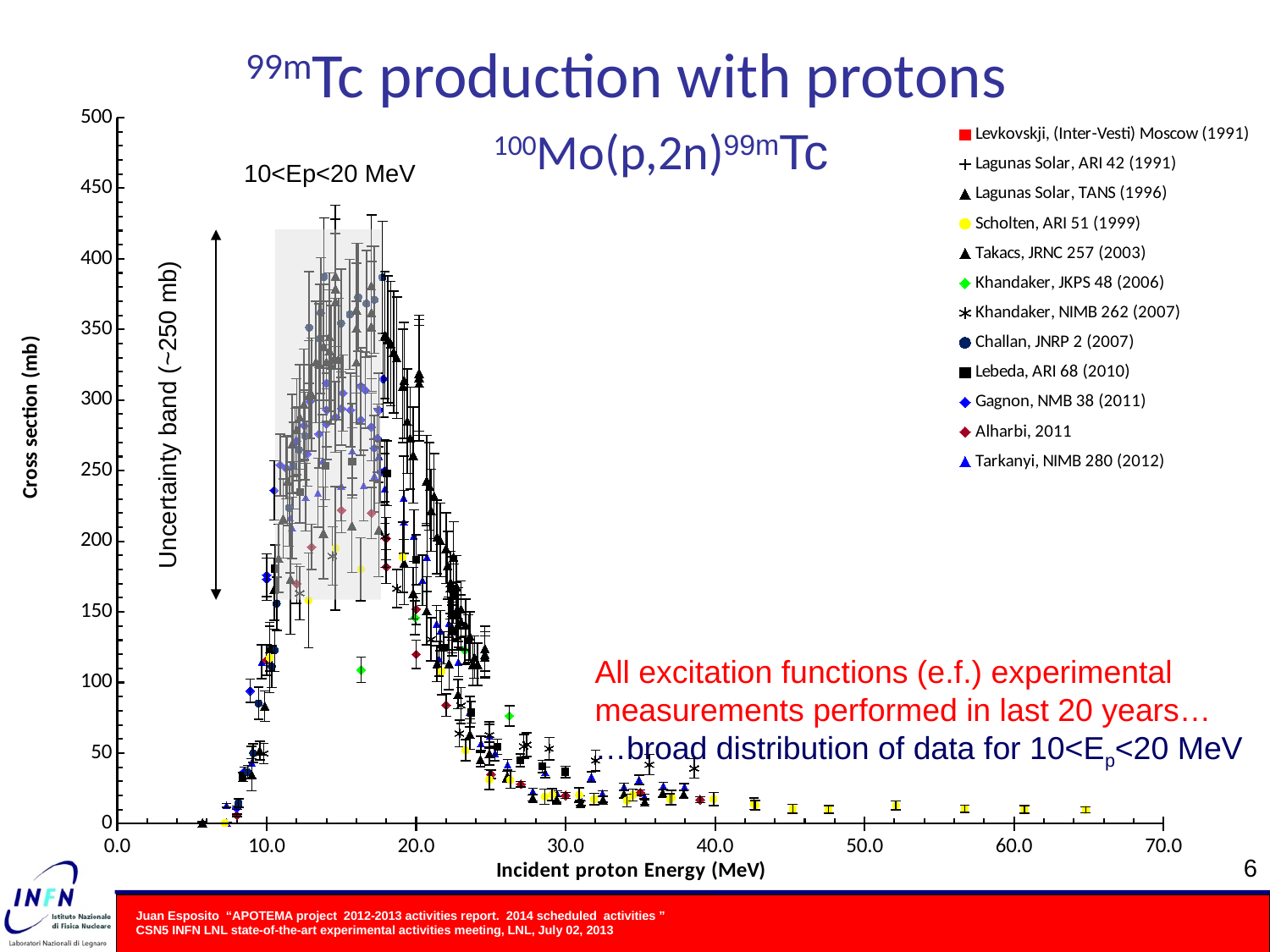
What is the highest value shown on the x axis? 70.0 Which legend entry is plotted with a red square marker? Levkovskji, (Inter-Vesti) Moscow (1991) What is the label of the y axis? Cross section (mb) Is the cross section value for Khandaker, JKPS 48 (2006) at about 16 MeV greater or less than 150? less What kind of chart is shown on the slide? scatter plot According to the annotation on the chart, roughly how wide is the uncertainty band in the 10<Ep<20 MeV region? ~250 mb Between 30 MeV and 70 MeV on the x axis, do the cross section values rise or fall? fall Between 5 MeV and 15 MeV on the x axis, do the cross section values rise or fall? rise How many data series does the legend list? 12 What is the highest value shown on the y axis? 500 Is the cross section value for Scholten, ARI 51 (1999) at about 60 MeV greater or less than 50? less